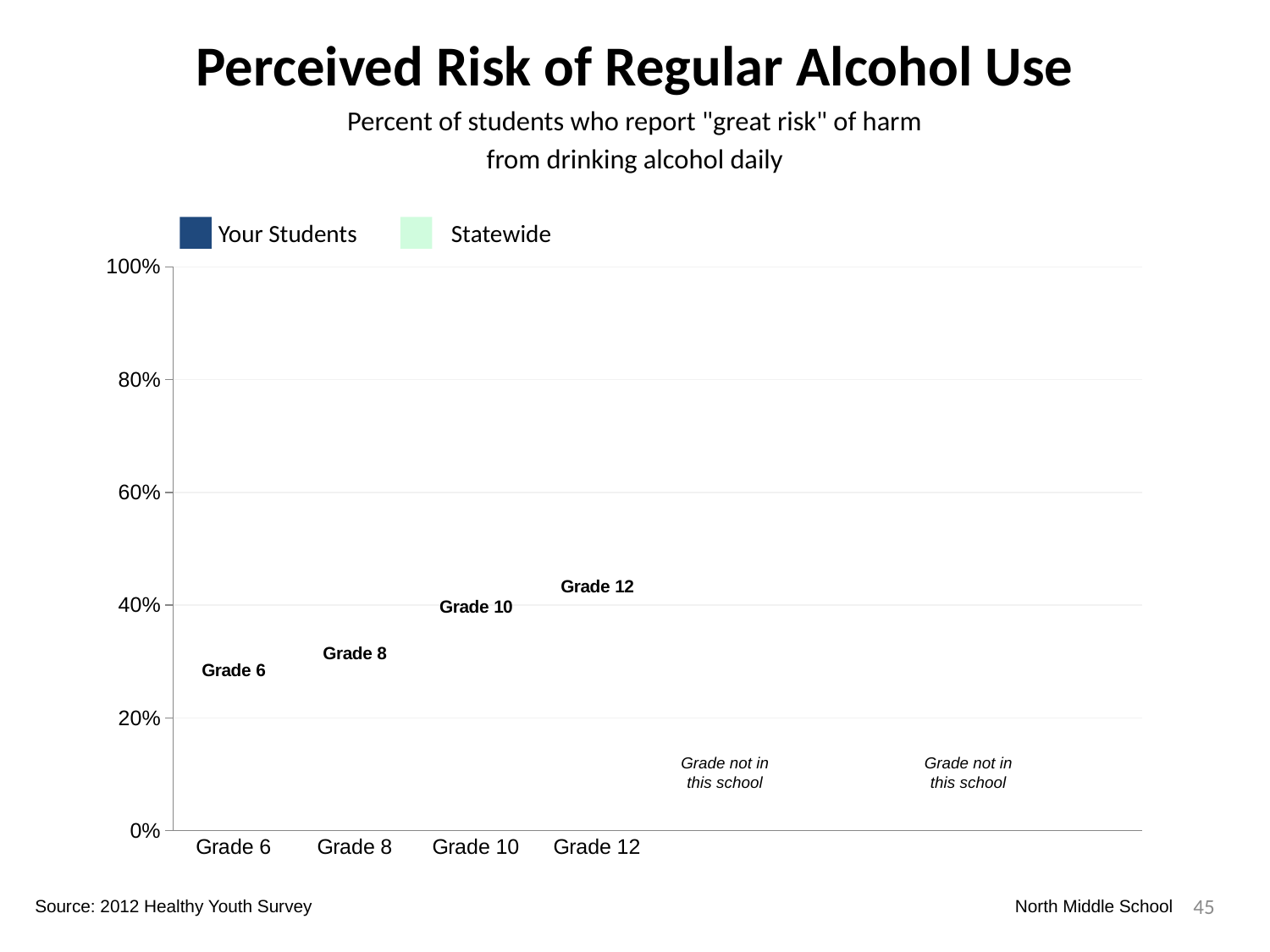
How many grade categories are labeled on the x axis of the chart? 4 What are the two series named in the chart's legend? Your Students and Statewide What is the lowest value shown on the chart's y axis? 0% How many series does the chart's legend list? 2 What is the title of the chart? Perceived Risk of Regular Alcohol Use What is the highest value shown on the chart's y axis? 100%